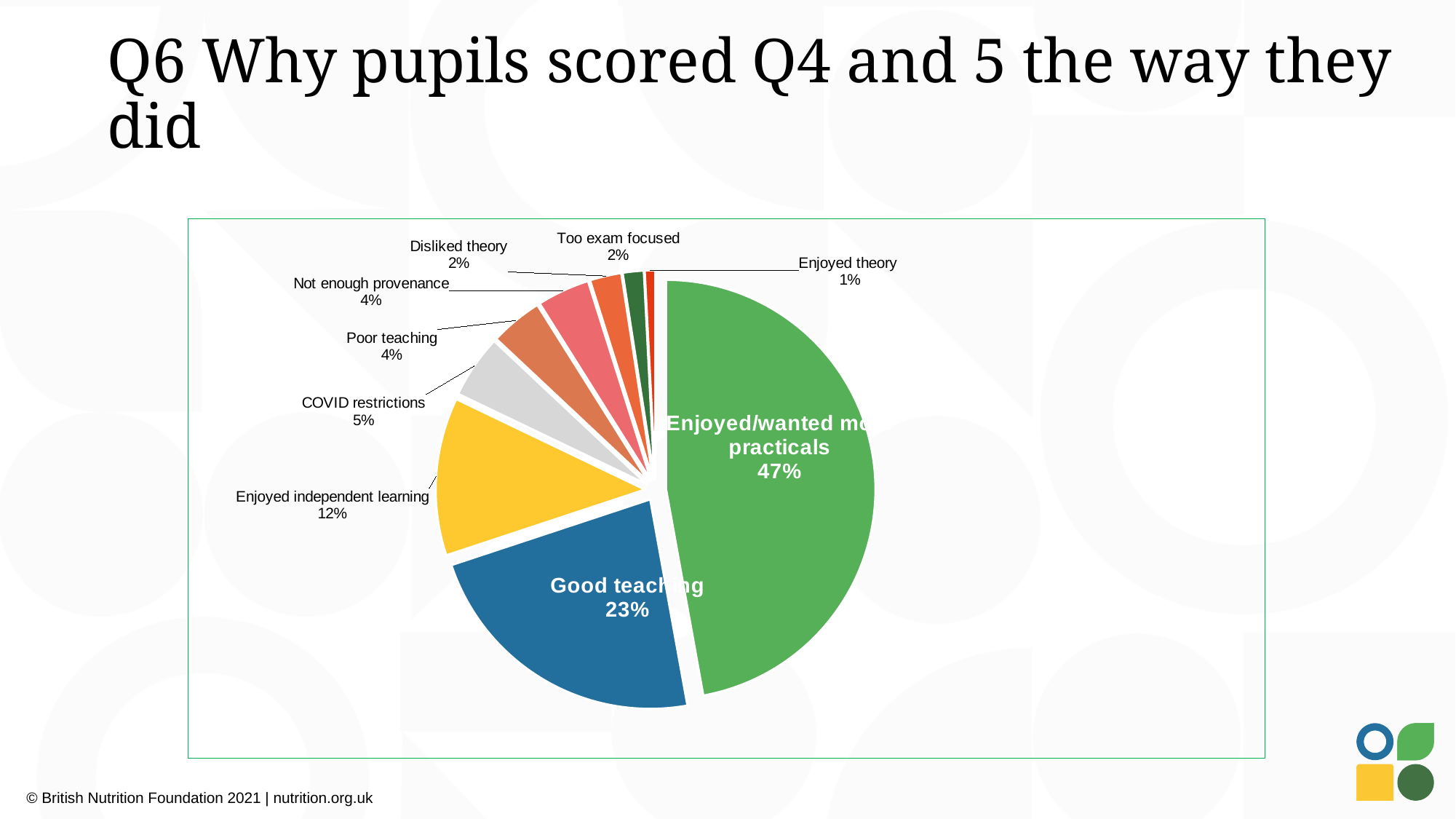
What is the difference in percentage points between 'Enjoyed/wanted more practicals' and 'Good teaching'? 24 What percentage of pupils gave 'Good teaching' as their reason? 23% What kind of chart is shown on the slide? pie chart How many categories are shown in the pie chart? 9 Which category has the smallest slice of the pie? Enjoyed theory What percentage is shown for 'Enjoyed theory'? 1% Which is larger, 'Enjoyed independent learning' or 'COVID restrictions'? Enjoyed independent learning What percentage is shown for 'COVID restrictions'? 5% What percentage is shown for 'Not enough provenance'? 4% Which category has the largest slice of the pie? Enjoyed/wanted more practicals What share of the pie is 'Enjoyed independent learning'? 12% What is the title of the slide containing the pie chart? Q6 Why pupils scored Q4 and 5 the way they did